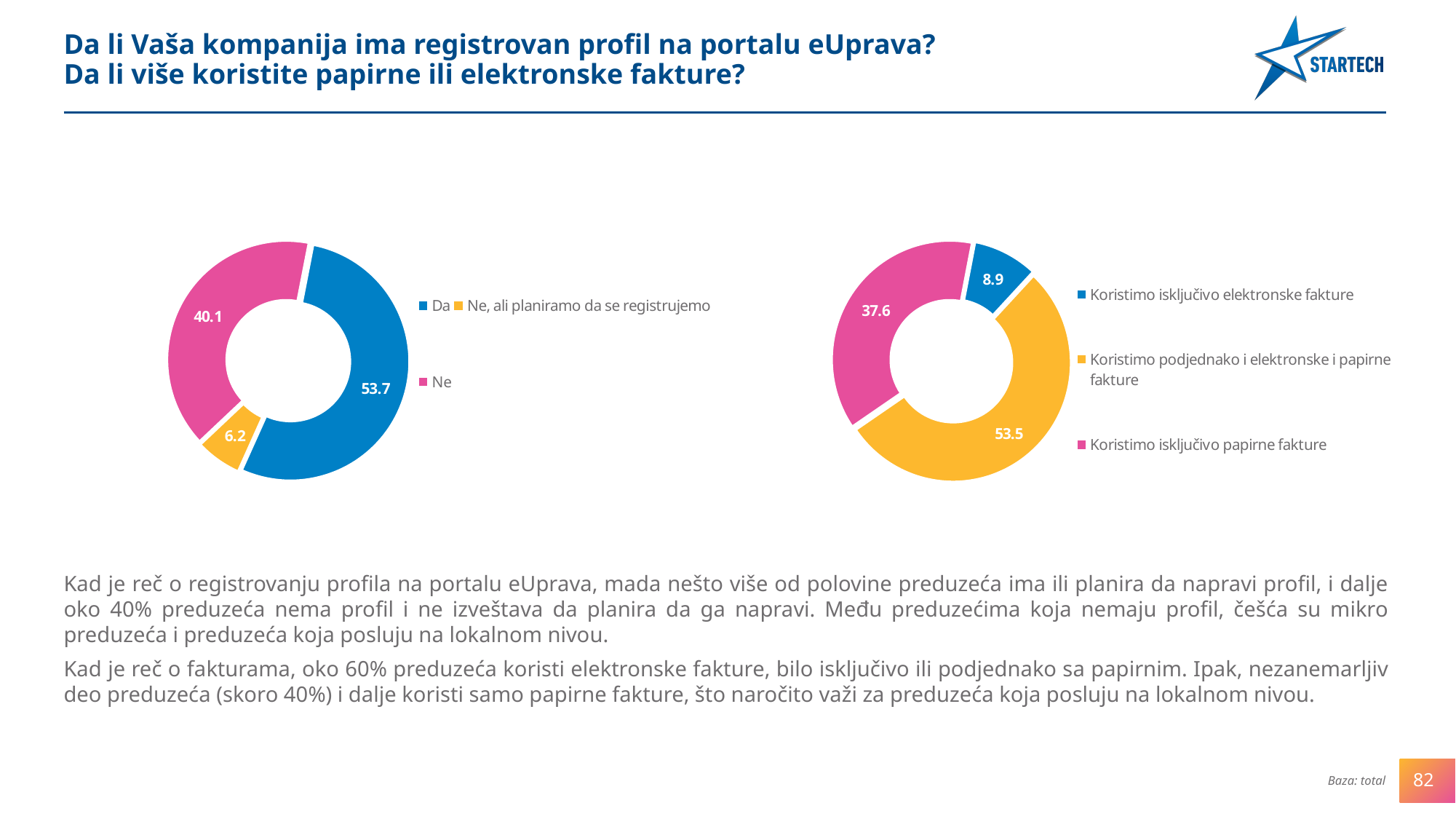
In the right chart, which category has the largest share? Koristimo podjednako i elektronske i papirne fakture What type of chart is the right chart? Doughnut chart In the left chart, what is the difference between the values for "Da" and "Ne"? 13.6 In the right chart, what is the value for "Koristimo isključivo elektronske fakture"? 8.9 In the left chart, which category has the smallest share? Ne, ali planiramo da se registrujemo In the left chart, what is the value for "Ne, ali planiramo da se registrujemo"? 6.2 In the left chart, what is the value for "Da"? 53.7 In the right chart, which is larger: "Koristimo isključivo papirne fakture" or "Koristimo isključivo elektronske fakture"? Koristimo isključivo papirne fakture In the left chart, what is the value for "Ne"? 40.1 In the left chart, which category has the largest share? Da In the right chart, what is the value for "Koristimo isključivo papirne fakture"? 37.6 In the right chart, what is the value for "Koristimo podjednako i elektronske i papirne fakture"? 53.5